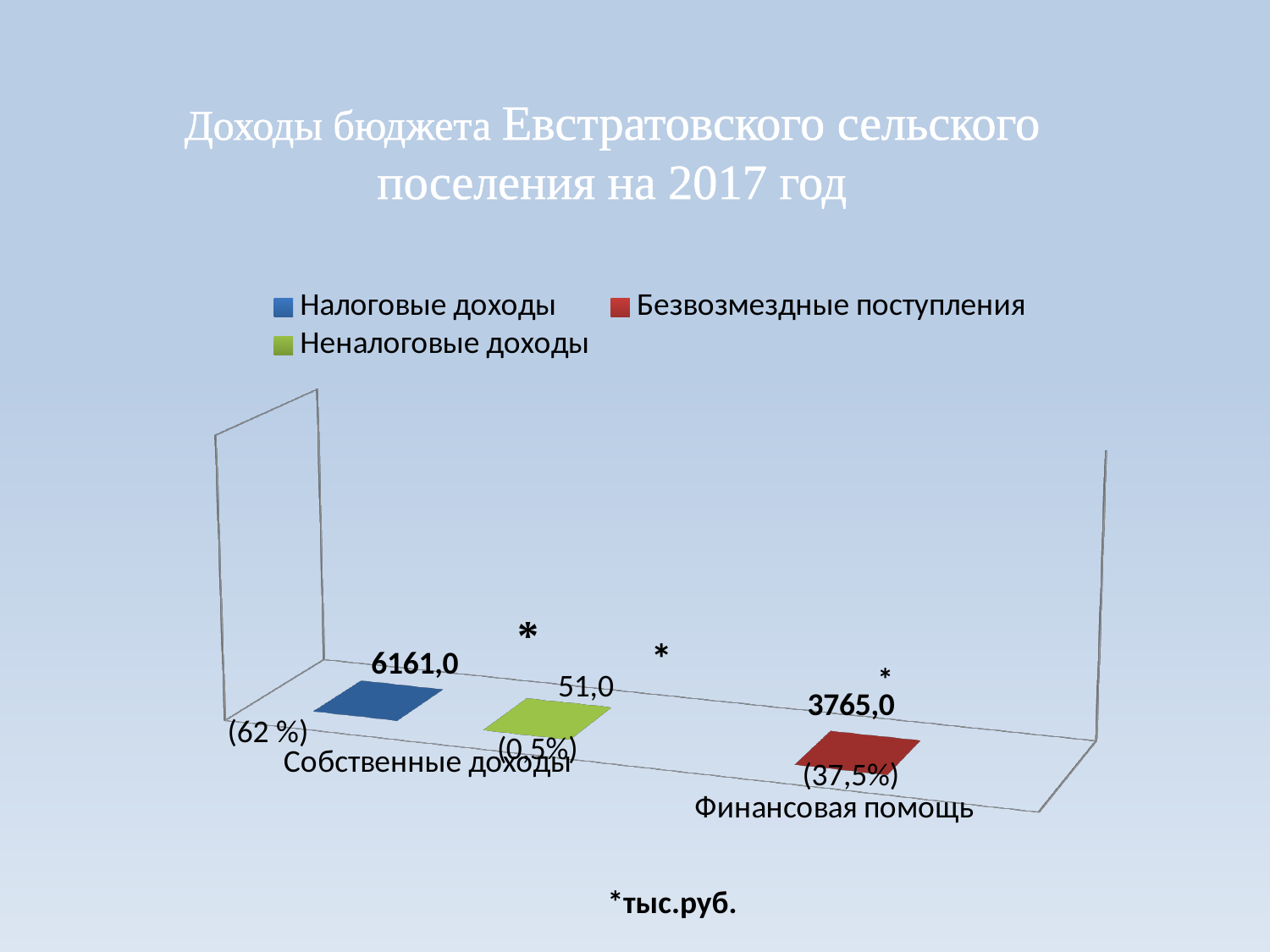
What is the value labelled for Налоговые доходы? 6161,0 What are the two category labels shown along the x axis? Собственные доходы, Финансовая помощь What percentage share is shown next to the Налоговые доходы value? (62 %) What unit does the footnote say the values are in? тыс.руб. What is the value labelled for Безвозмездные поступления? 3765,0 What percentage share is shown next to the Безвозмездные поступления value? (37,5%) What is the difference between the Налоговые доходы value and the Безвозмездные поступления value? 2396,0 Which series has the highest labelled value? Налоговые доходы Which is larger, the value for Налоговые доходы or the value for Безвозмездные поступления? Налоговые доходы What is the value labelled for Неналоговые доходы? 51,0 How many series does the legend list? 3 Which series has the lowest labelled value? Неналоговые доходы